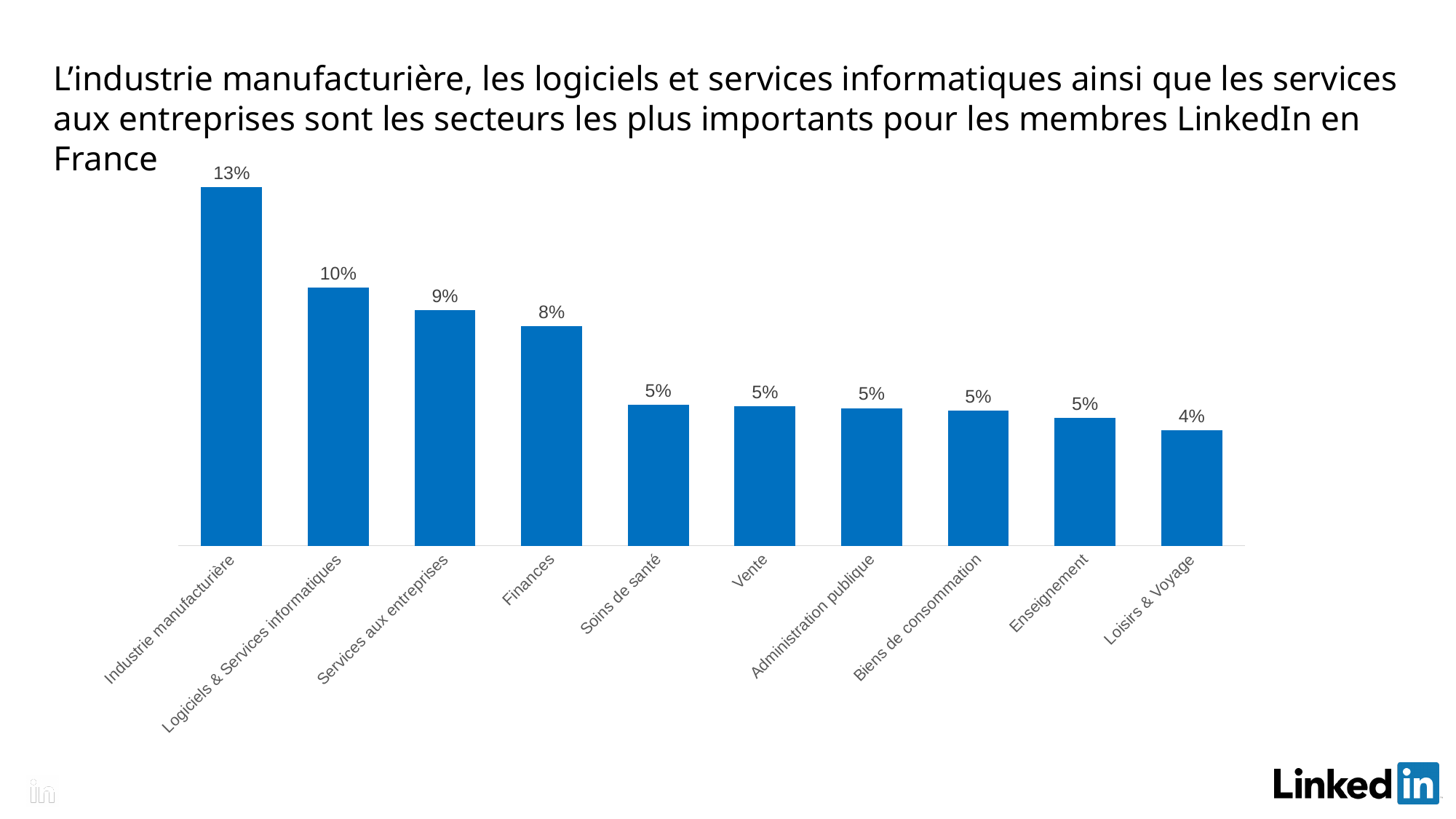
What is the difference between the values for Industrie manufacturière and Services aux entreprises? 4% What is the value for Loisirs & Voyage? 4% What is the value for Logiciels & Services informatiques? 10% What is the value for Industrie manufacturière? 13% How many categories are shown in the chart? 10 Which category has the lowest value? Loisirs & Voyage What kind of chart is shown on the slide? Bar chart Which is larger, the value for Logiciels & Services informatiques or the value for Finances? Logiciels & Services informatiques How many categories have a value of 5%? 5 What is the value for Finances? 8% Which category has the highest value? Industrie manufacturière Do the values rise or fall from left to right along the x axis? Fall